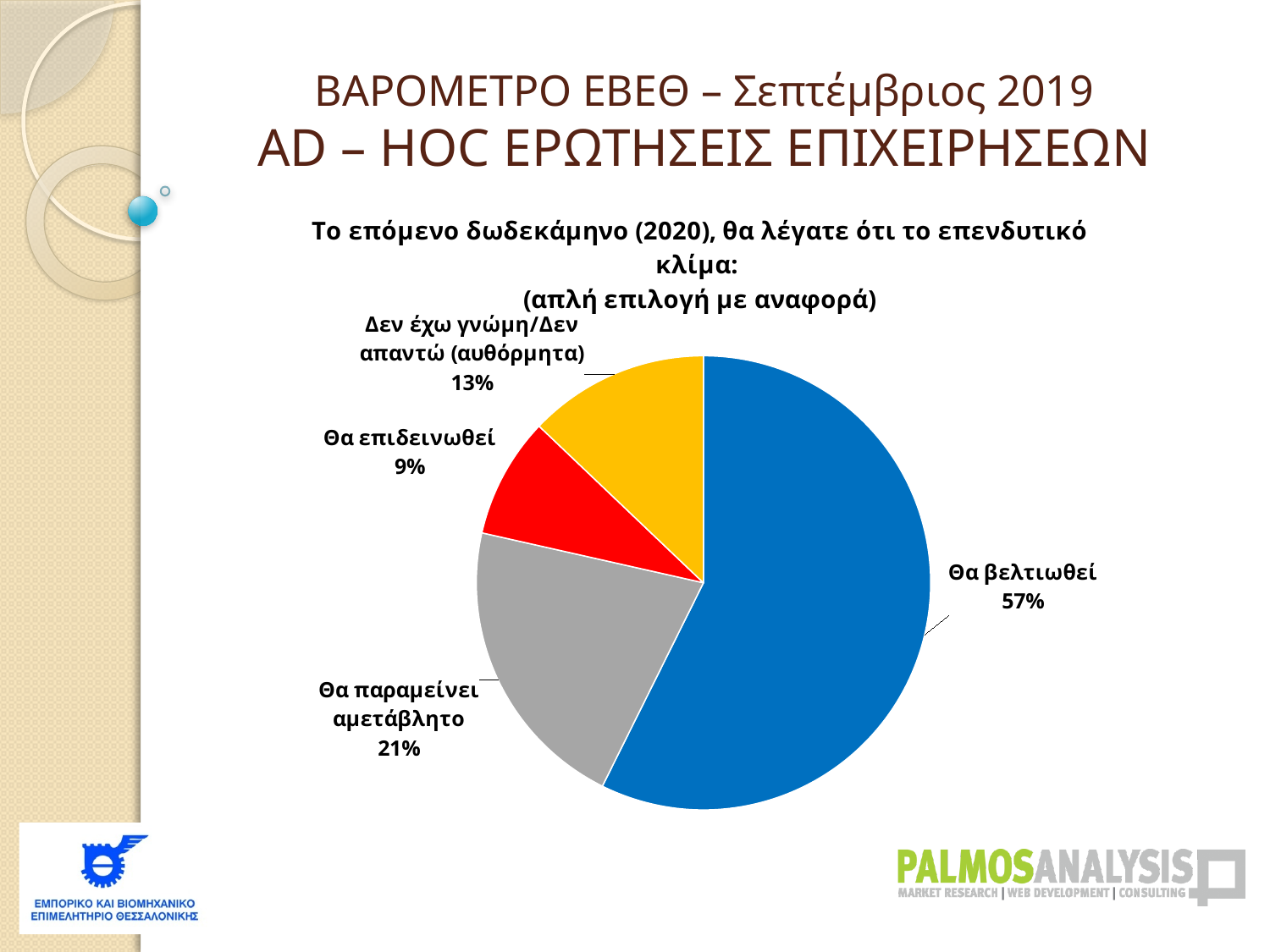
What is the difference in percentage points between "Θα βελτιωθεί" and "Θα παραμείνει αμετάβλητο"? 36 percentage points What percentage of respondents answered "Θα επιδεινωθεί"? 9% Which response has the largest share of the pie? Θα βελτιωθεί What type of chart is shown on the slide? pie chart Which response has the smallest share of the pie? Θα επιδεινωθεί Which is larger: the share for "Δεν έχω γνώμη/Δεν απαντώ (αυθόρμητα)" or the share for "Θα επιδεινωθεί"? Δεν έχω γνώμη/Δεν απαντώ (αυθόρμητα) What colour is the slice for "Θα επιδεινωθεί"? red What colour is the slice for "Θα παραμείνει αμετάβλητο"? grey How many slices does the pie chart have? 4 What percentage of respondents answered "Δεν έχω γνώμη/Δεν απαντώ (αυθόρμητα)"? 13% What percentage of respondents answered "Θα παραμείνει αμετάβλητο"? 21% What percentage of respondents answered "Θα βελτιωθεί"? 57%